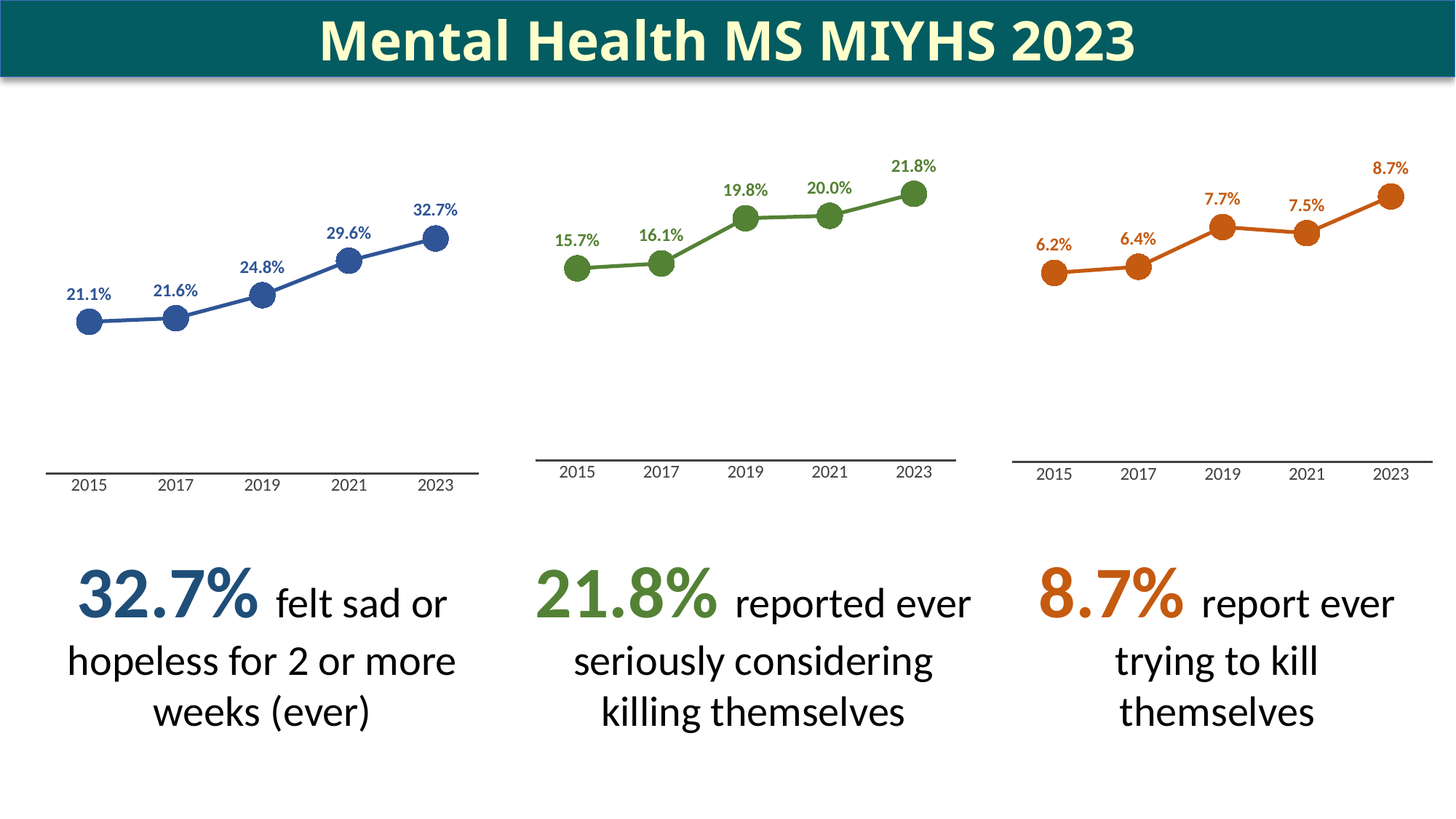
How many data points are plotted in the middle (green) chart? 5 In the left (blue) chart, what is the value for 2019? 24.8% What kind of chart is the left (blue) chart? line chart In the left (blue) chart, which year has the highest value? 2023 In the middle (green) chart, what is the value for 2021? 20.0% In the middle (green) chart, do the values generally rise or fall from 2015 to 2023? rise In the right (orange) chart, what is the value for 2015? 6.2% What is the title of the slide? Mental Health MS MIYHS 2023 In the middle (green) chart, what is the difference between the 2019 and 2017 values? 3.7% In the right (orange) chart, which year has the lowest value? 2015 In the left (blue) chart, what is the difference between the 2023 and 2015 values? 11.6% In the right (orange) chart, which is larger, the value for 2019 or the value for 2021? 2019